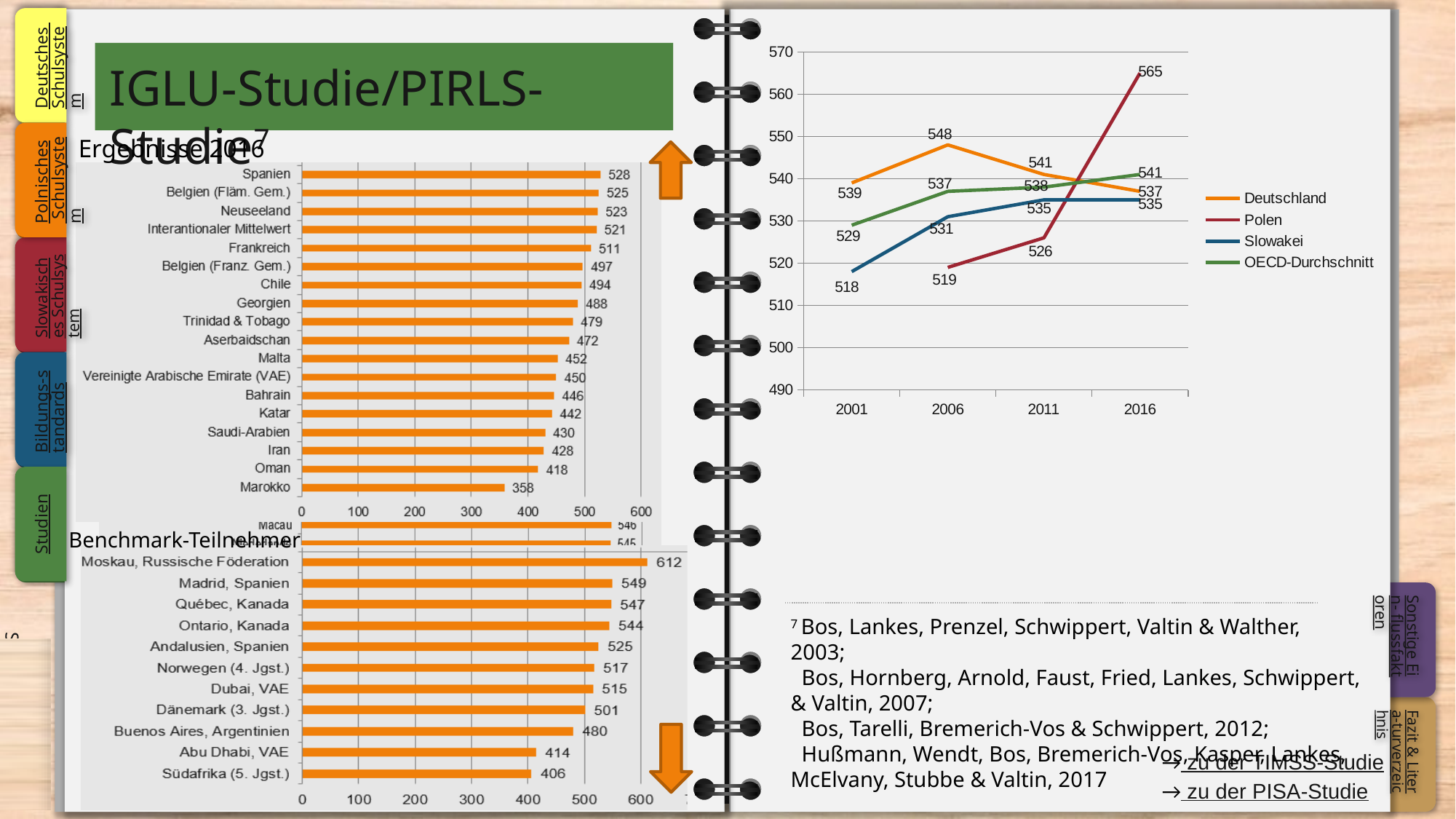
In the line chart on the right, which is larger in 2011: Slowakei or OECD-Durchschnitt? OECD-Durchschnitt In the line chart on the right, what is the value for Deutschland in 2006? 548 What kind of chart is the chart on the right side of the slide? line chart In the 'Ergebnisse 2016' bar chart on the left, what is the value for Marokko? 358 In the 'Ergebnisse 2016' bar chart on the left, which category has the highest value? Spanien In the line chart on the right, how many series does the legend list? 4 In the line chart on the right, which series has the lowest value in 2001? Slowakei In the line chart on the right, what value does Polen reach in 2016? 565 In the 'Benchmark-Teilnehmer' bar chart at the bottom left, which category has the highest value? Moskau, Russische Föderation In the line chart on the right, does the value for Deutschland rise or fall from 2006 to 2016? fall In the line chart on the right, what is the difference between Polen and Deutschland in 2016? 28 In the 'Ergebnisse 2016' bar chart on the left, what is the value for Internationaler Mittelwert? 521